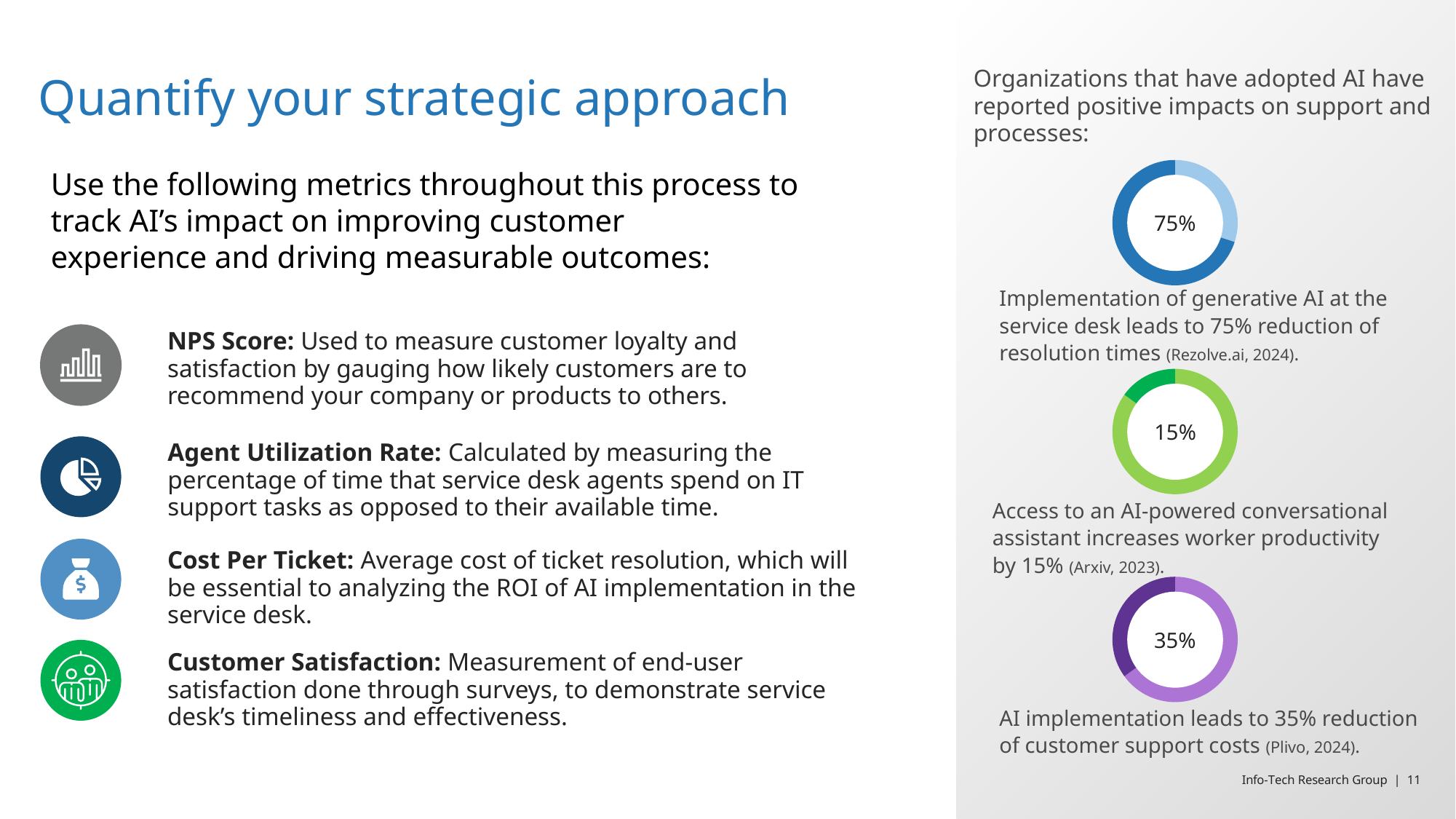
Which of the three donut charts shows the highest percentage? The top chart (75%, reduction of resolution times) What is the difference between the value in the top donut chart and the value in the bottom donut chart? 40 percentage points What kind of charts are shown on the right side of the slide? Donut charts How many donut charts are shown on the slide? 3 Which is larger: the value in the top donut chart or the value in the bottom donut chart? The top donut chart (75%) Which of the three donut charts shows the lowest percentage? The middle chart (15%, worker productivity increase) What colour is the top donut chart on the slide? Blue What is the difference between the value in the bottom donut chart and the value in the middle donut chart? 20 percentage points What value is shown in the centre of the bottom donut chart (reduction of customer support costs)? 35% What value is shown in the centre of the middle donut chart (AI-powered conversational assistant)? 15% Is the value shown in the middle donut chart greater or less than 50%? less What value is shown in the centre of the top donut chart on the right side of the slide? 75%